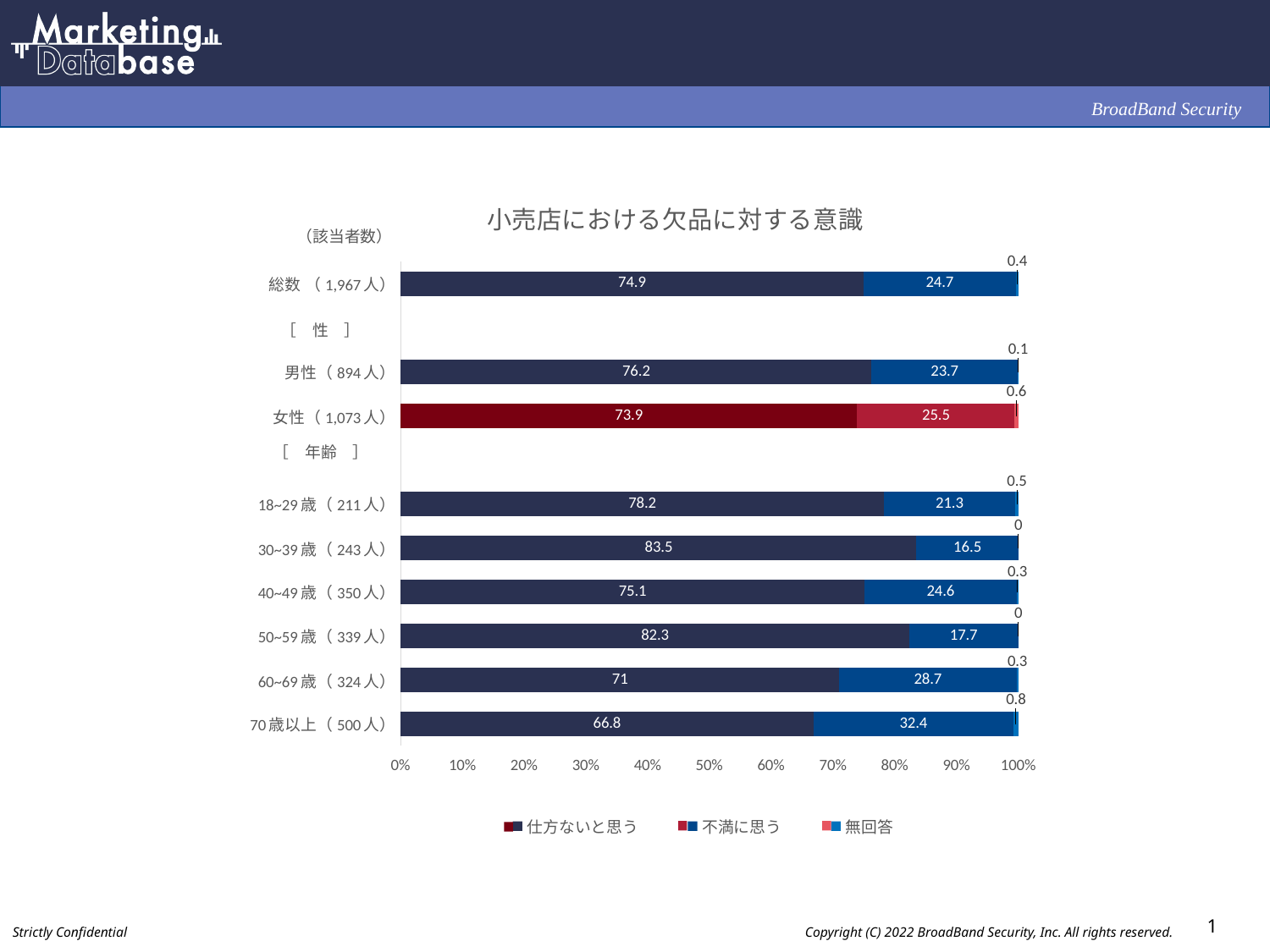
How many series does the legend list? 3 What is the total of the stacked bar for 40~49歳 (350人)? 100 What is the difference between the 不満に思う values for 女性 (1,073人) and 男性 (894人)? 1.8 Which category has the lowest value for 仕方ないと思う? 70歳以上 (500人) What kind of chart is shown on the slide? Stacked bar chart Which is larger, the 仕方ないと思う value for 50~59歳 (339人) or for 60~69歳 (324人)? 50~59歳 (339人) What is the value of 不満に思う for 70歳以上 (500人)? 32.4 Which category has the highest value for 仕方ないと思う? 30~39歳 (243人) What is the value of 仕方ないと思う for 総数 (1,967人)? 74.9 Is the 仕方ないと思う value for 18~29歳 (211人) greater or less than 70%? greater What is the value of 無回答 for 女性 (1,073人)? 0.6 What is the title of the chart? 小売店における欠品に対する意識